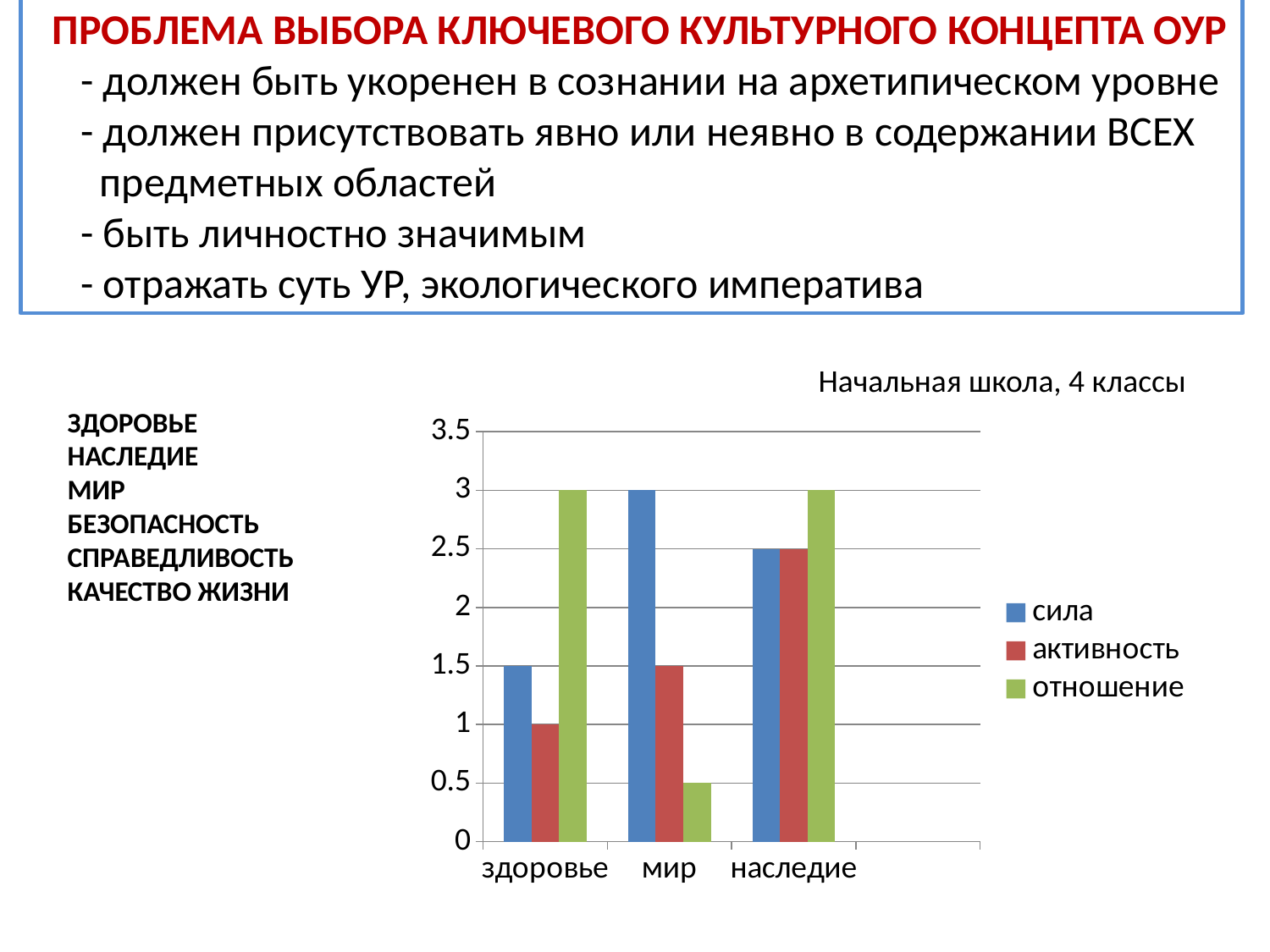
What kind of chart is shown on the slide? bar chart Which category has the highest value for сила? мир How many series does the chart legend list? 3 What is the value of активность for здоровье? 1 What is the value of отношение for мир? 0.5 What is the difference between сила and активность for мир? 1.5 What is the value of сила for мир? 3 Which category has the lowest value for отношение? мир Is the value of сила for наследие greater or less than 2? greater Which is larger for здоровье: сила or отношение? отношение How many categories are shown on the x axis of the chart? 3 What is the text shown above the chart as its caption? Начальная школа, 4 классы